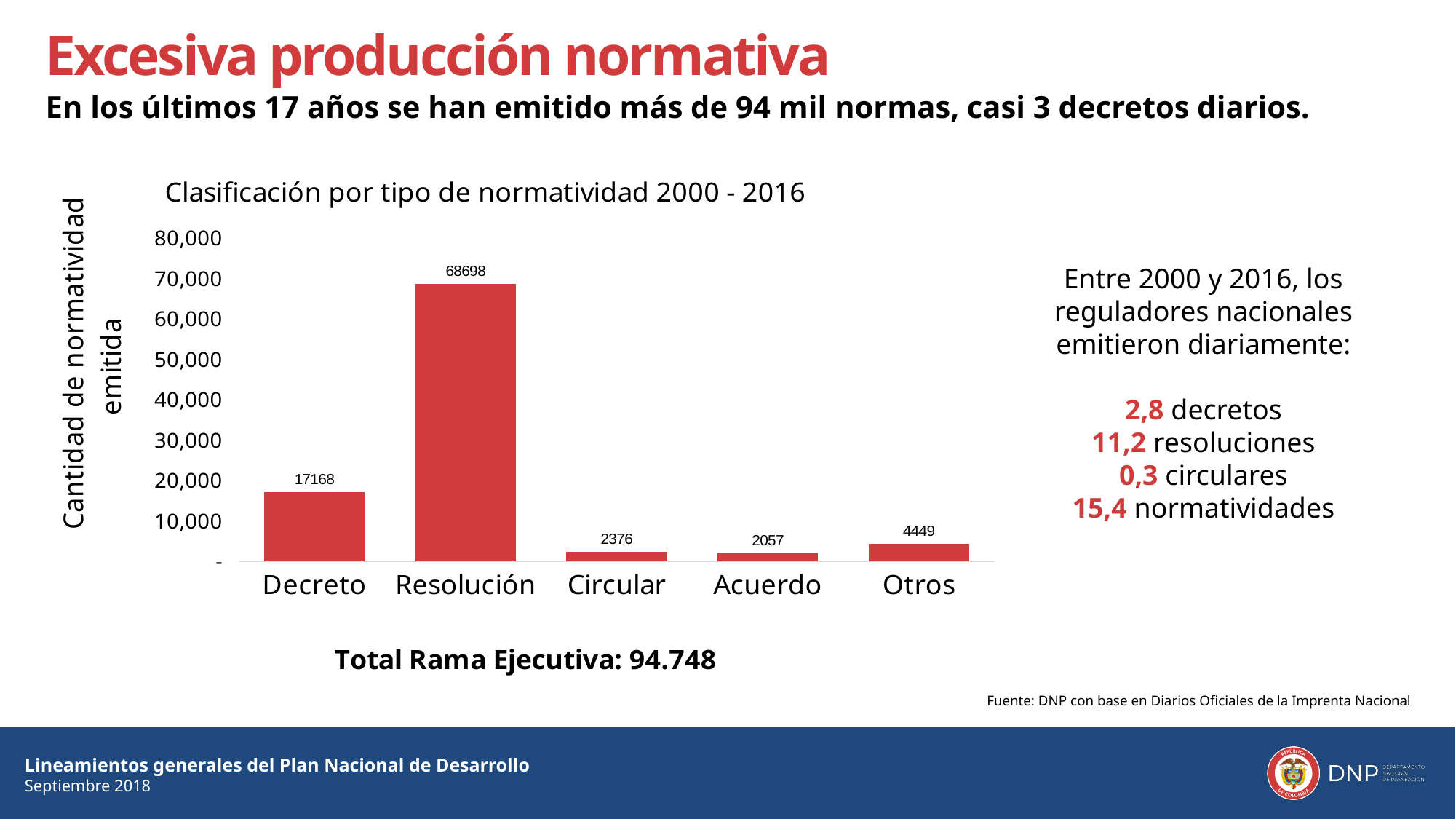
What is the value for Circular? 2376 How many categories are shown on the x axis? 5 Is the value for Decreto greater or less than 20,000? less What is the value for Otros? 4449 What is the difference between the values for Resolución and Decreto? 51530 What type of chart is shown on the slide? bar chart Which category has the highest value? Resolución What is the value for Resolución? 68698 What is the value for Decreto? 17168 Which category has the lowest value? Acuerdo What is the value for Acuerdo? 2057 Which is larger, the value for Otros or the value for Circular? Otros